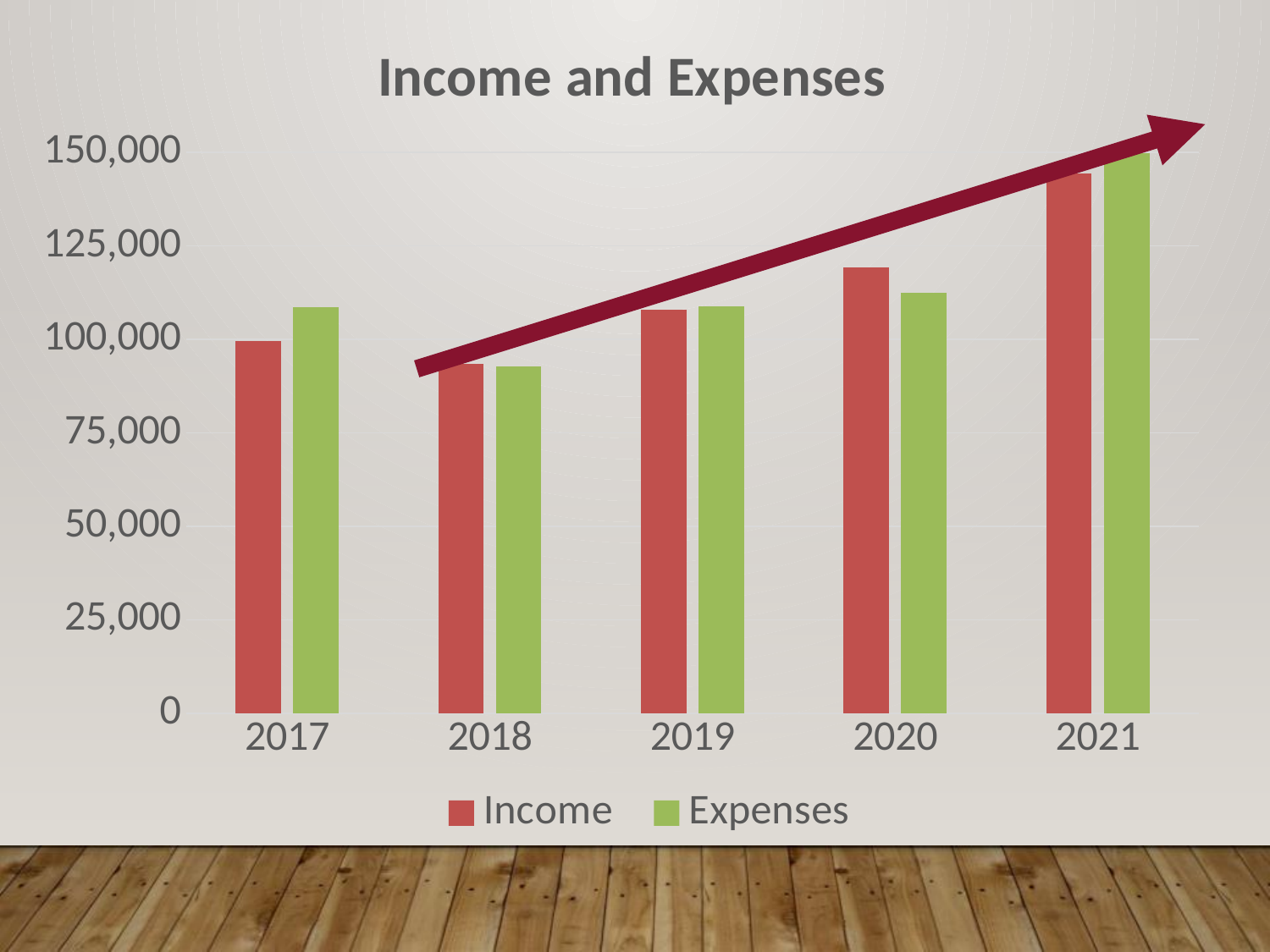
In which year is Income highest? 2021 In which year is Income lowest? 2018 How many years are shown on the x axis? 5 Is the value for Expenses in 2017 greater or less than 100,000? greater How many series does the legend list? 2 Is the value for Income in 2018 greater or less than 100,000? less In 2020, which is larger, Income or Expenses? Income What type of chart is shown on the slide? Bar chart Is the value for Income in 2021 greater or less than 125,000? greater In which year are Expenses lowest? 2018 What is the title of the chart? Income and Expenses Which colour represents Expenses in the legend? Green